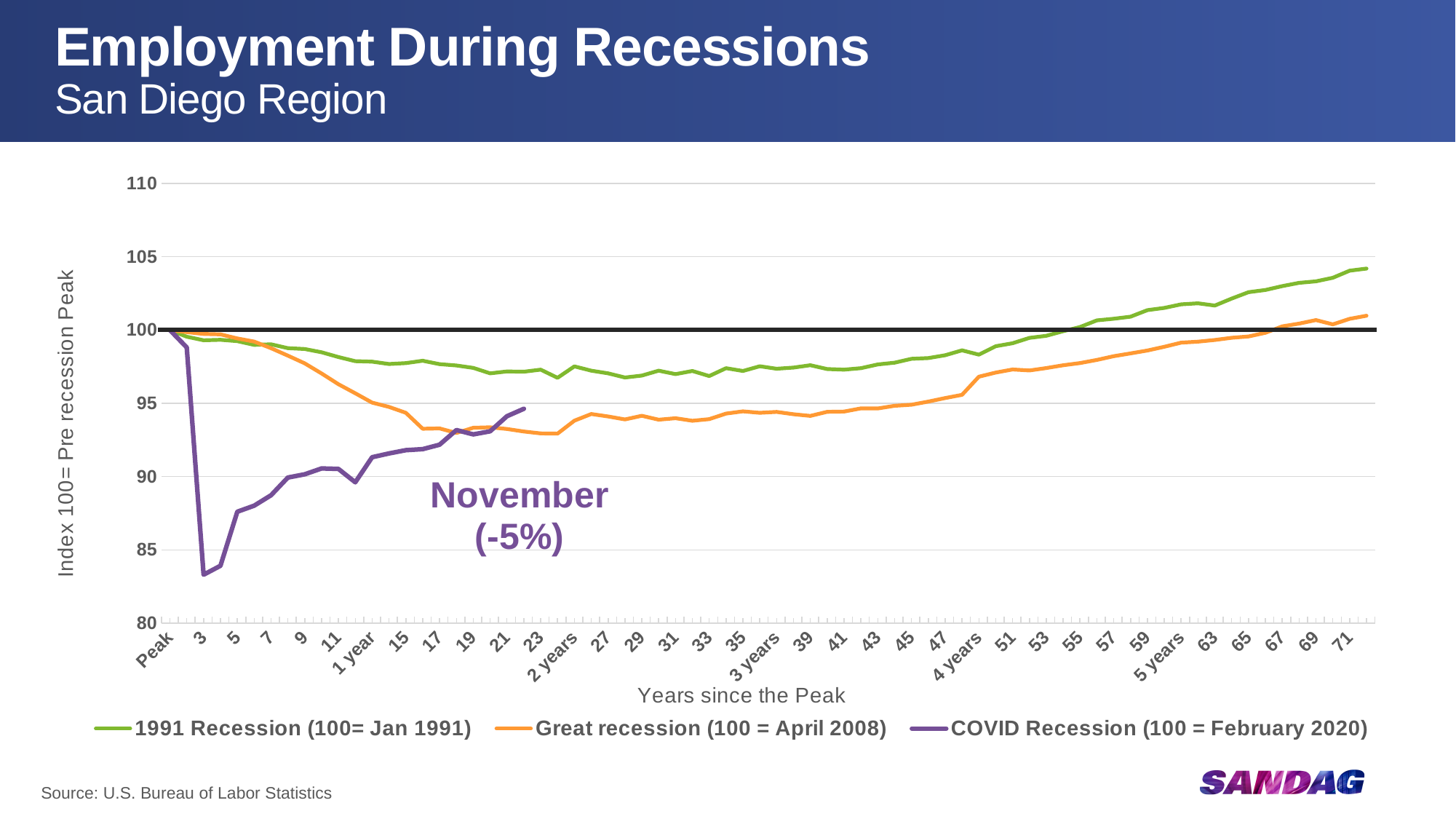
Which series reaches the lowest index value on the chart? COVID Recession (100 = February 2020) At 1 year since the peak, which line is higher: the 1991 Recession or the COVID Recession? 1991 Recession How many series does the legend list? 3 Is the lowest value of the COVID Recession line greater or less than 85? less Does the 1991 Recession line rise or fall between 4 years and month 71? Rise What is the title of the chart on the slide? Employment During Recessions What kind of chart is shown on the slide? Line chart Is the value of the Great recession line at 2 years greater or less than 95? less At 3 years since the peak, which line is higher: the 1991 Recession or the Great recession? 1991 Recession What is the label of the x axis? Years since the Peak Is the value of the 1991 Recession line at month 71 greater or less than 100? greater What percentage change is annotated for November on the COVID Recession line? -5%